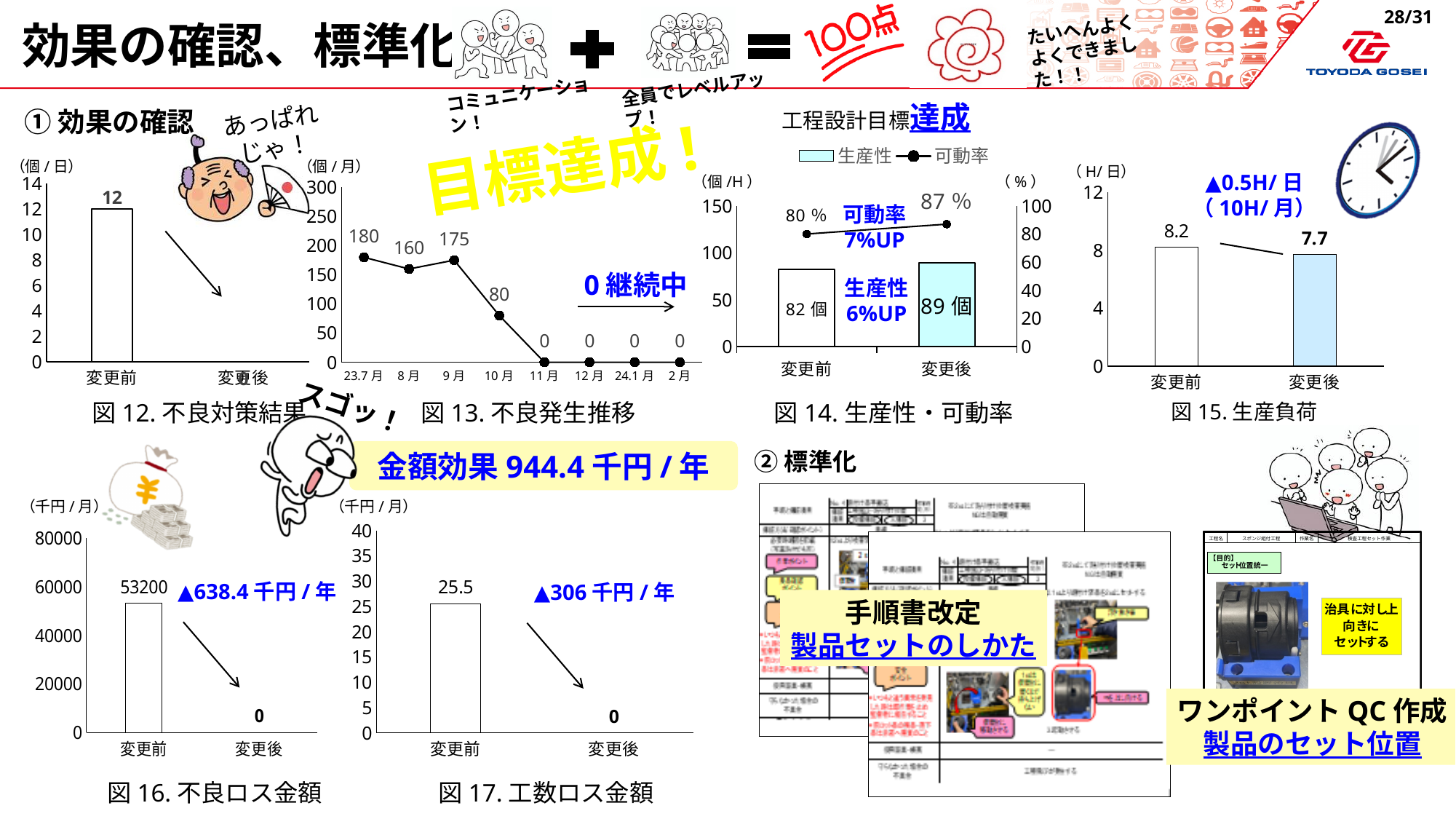
In 図 13. 不良発生推移, which month has the highest value? 23.7月 In 図 15. 生産負荷, what is the difference between 変更前 and 変更後? 0.5 In 図 12. 不良対策結果, what is the value for 変更前? 12 In 図 13. 不良発生推移, do the values rise or fall from 23.7月 to 2月? fall In 図 16. 不良ロス金額, what is the value for 変更前? 53200 In 図 13. 不良発生推移, how many months are plotted on the x axis? 8 In 図 14. 生産性・可動率, what is the 生産性 value for 変更後? 89 個 In 図 17. 工数ロス金額, which is larger, 変更前 or 変更後? 変更前 In 図 13. 不良発生推移, what is the value for 23.7月? 180 In 図 14. 生産性・可動率, what is the 可動率 value for 変更前? 80 % In 図 13. 不良発生推移, what is the value for 10月? 80 In 図 14. 生産性・可動率, how many series does the legend list? 2